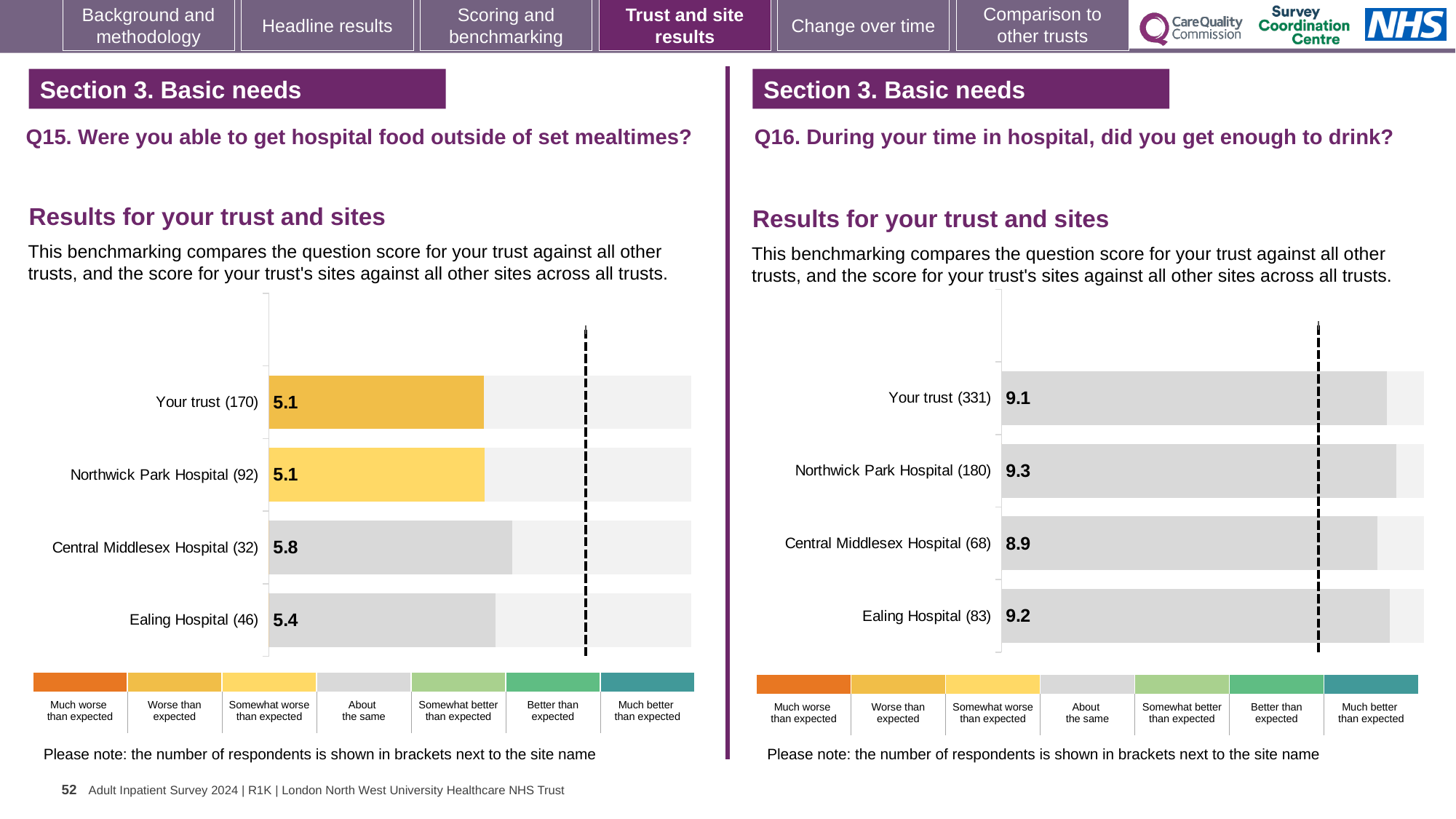
In the Q16 chart (right), what is the score for Ealing Hospital? 9.2 In the Q15 chart (left), what is the score for Your trust? 5.1 In the Q15 chart (left), what is the score for Central Middlesex Hospital? 5.8 In the Q16 chart (right), which site has the lowest score? Central Middlesex Hospital In the Q16 chart (right), which has the higher score, Your trust or Ealing Hospital? Ealing Hospital How many bars are shown in the Q15 chart (left)? 4 In the Q15 chart (left), what is the difference between the scores for Central Middlesex Hospital and Ealing Hospital? 0.4 In the Q15 chart (left), how many respondents are shown in brackets for Northwick Park Hospital? 92 In the Q16 chart (right), what is the difference between the scores for Northwick Park Hospital and Central Middlesex Hospital? 0.4 In the Q15 chart (left), which site has the highest score? Central Middlesex Hospital What kind of chart is used for the Q16 results (right)? Bar chart In the Q16 chart (right), what is the score for Northwick Park Hospital? 9.3